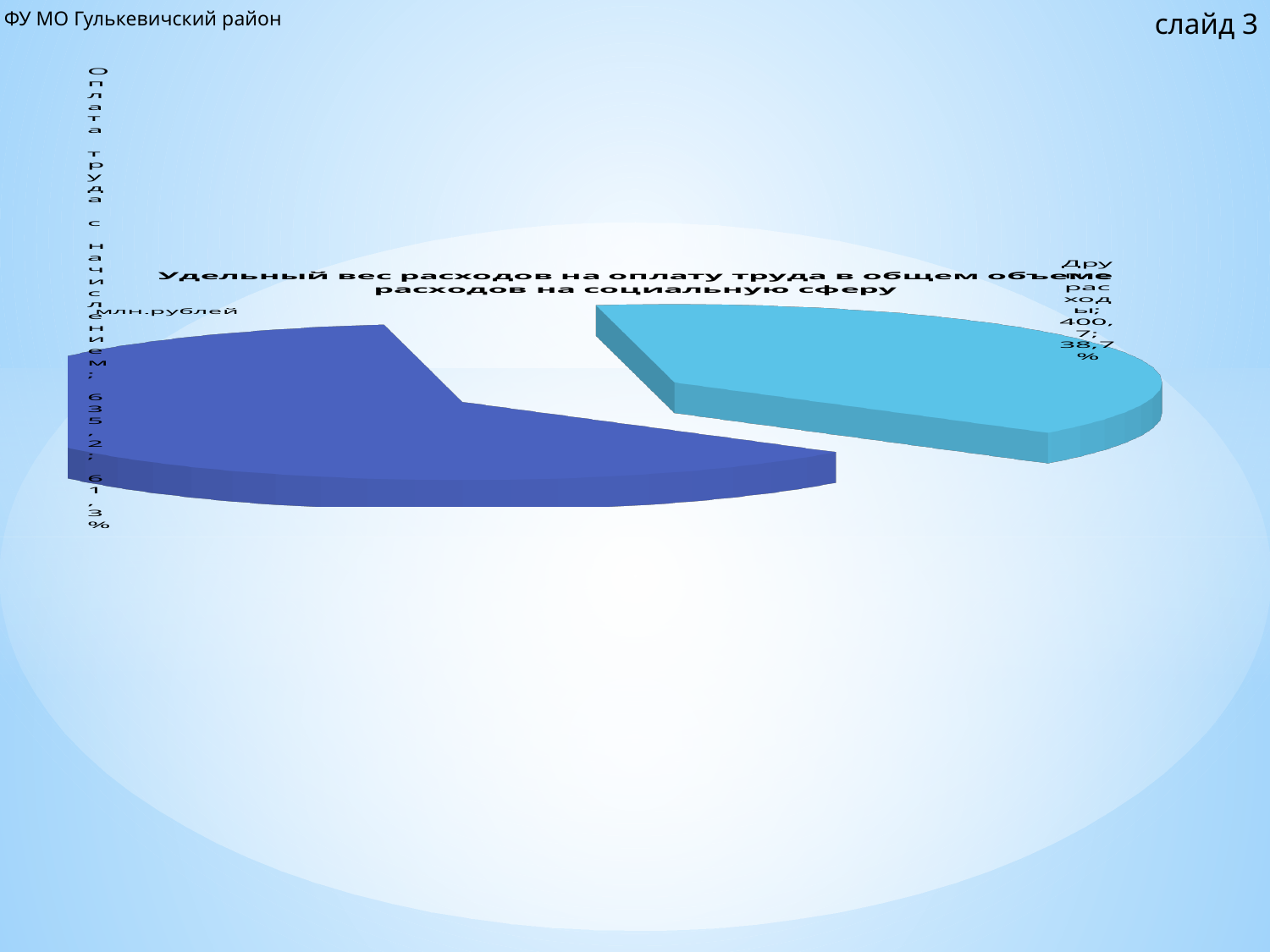
What kind of chart is shown on the slide? pie chart What is the difference between the values for "Оплата труда с начислением" and "Другие расходы"? 234,5 What share of the pie does "Оплата труда с начислением" represent? 61,3% Which slice is the smallest? Другие расходы What share of the pie does "Другие расходы" represent? 38,7% Which is larger, "Оплата труда с начислением" or "Другие расходы"? Оплата труда с начислением How many slices does the pie chart have? 2 What is the value for "Оплата труда с начислением"? 635,2 Which slice is the largest? Оплата труда с начислением What is the title of the chart? Удельный вес расходов на оплату труда в общем объеме расходов на социальную сферу What unit is indicated for the values on the chart? млн.рублей What is the value for "Другие расходы"? 400,7